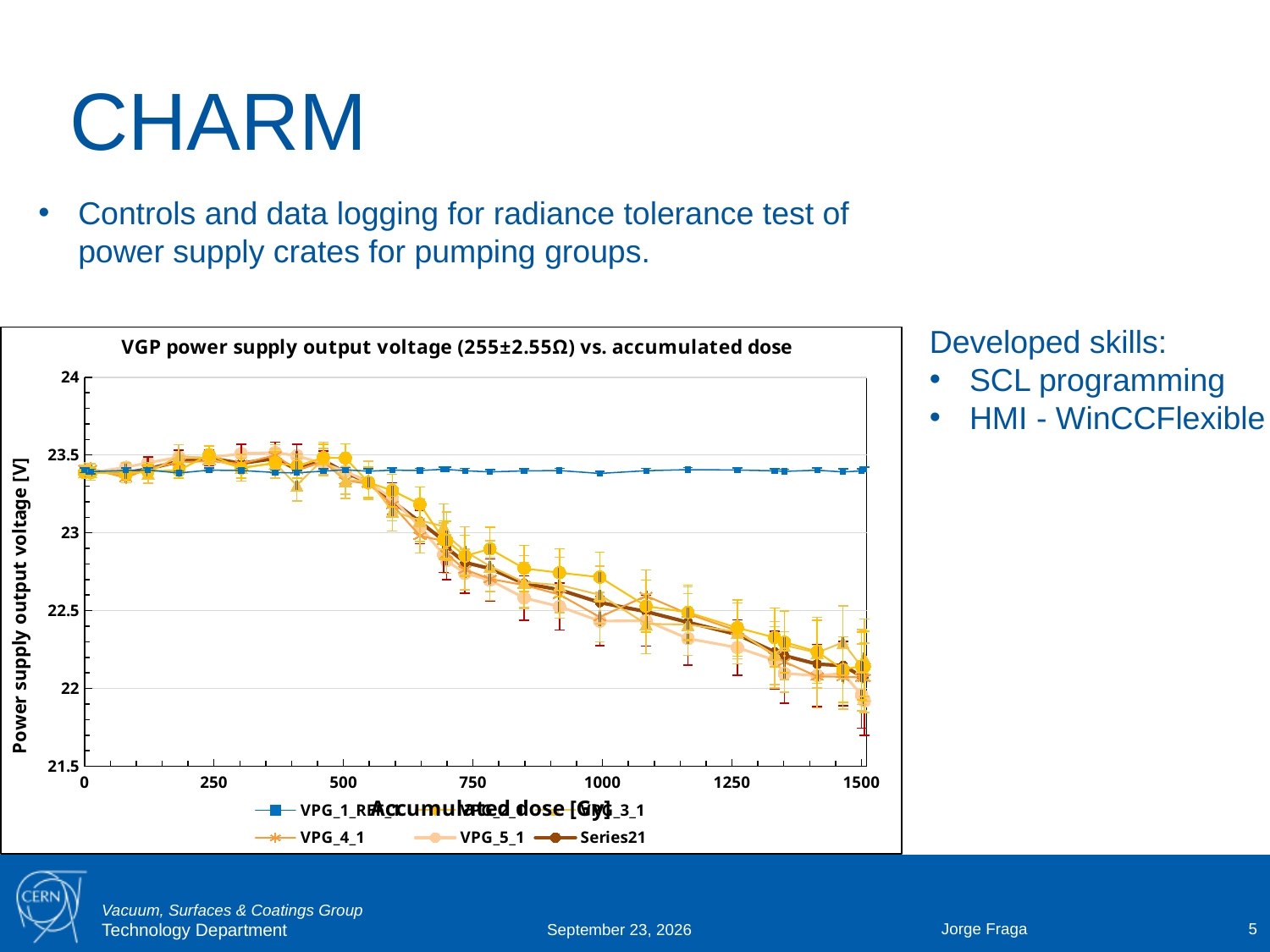
Does the Series21 line rise or fall as accumulated dose increases along the x axis? fall What is the label of the vertical axis of the chart? Power supply output voltage [V] What kind of chart is shown on the slide? line chart Does the VPG_1_REF line rise, fall, or stay roughly flat as accumulated dose increases? stays roughly flat What is the title of the chart? VGP power supply output voltage (255±2.55Ω) vs. accumulated dose Is the value of Series21 at an accumulated dose of 1500 greater or less than 22.5? less Which series has the highest output voltage at an accumulated dose of 1500? VPG_1_REF Is the value of VPG_3_1 at an accumulated dose of 0 greater or less than 23? greater How many series does the chart's legend list? 6 Is the value of VPG_1_REF at an accumulated dose of 1500 greater or less than 23? greater At an accumulated dose of 1500, which is larger: VPG_1_REF or Series21? VPG_1_REF